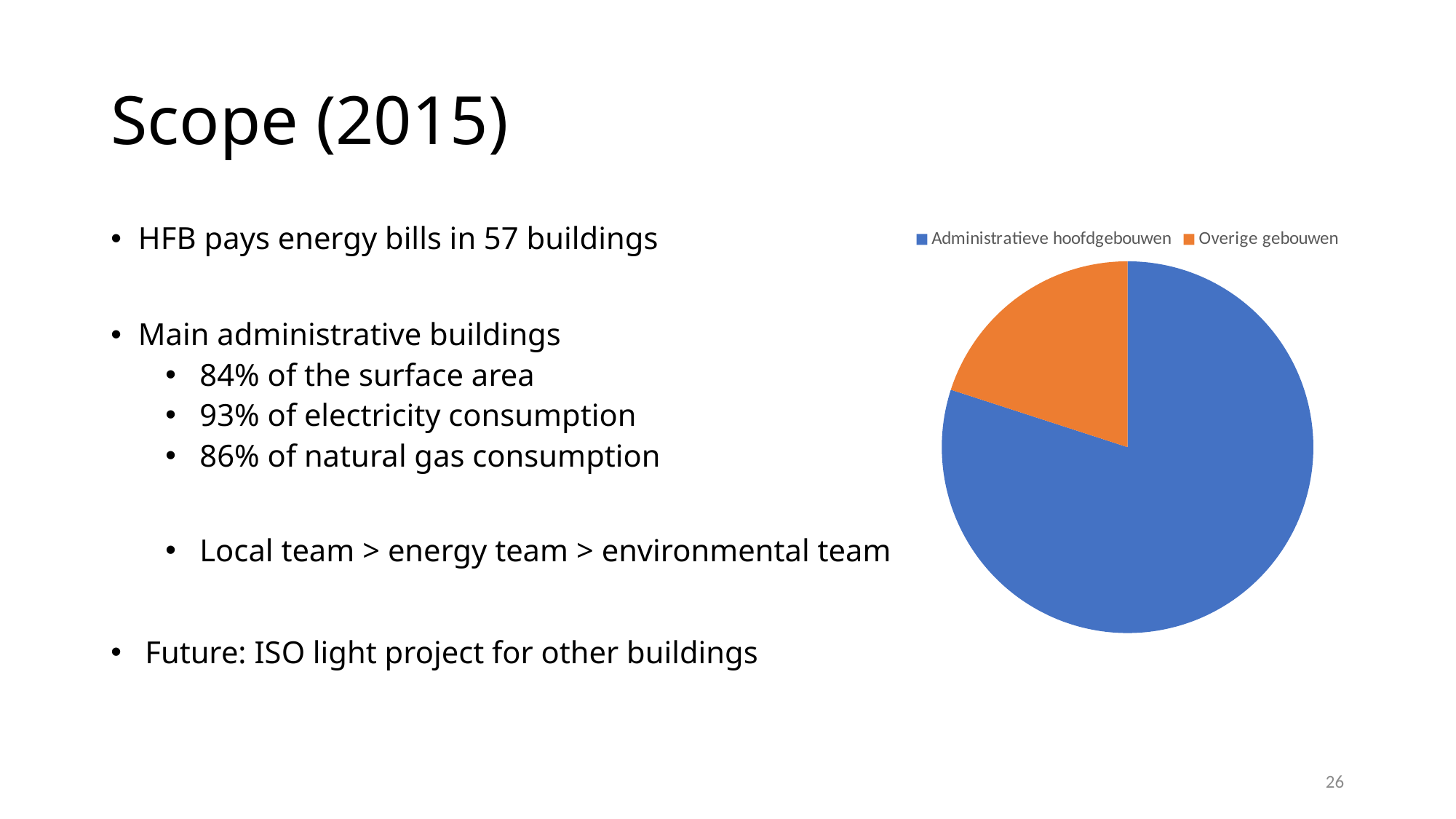
What kind of chart is shown on the slide? pie chart Which slice of the pie chart is the smallest? Overige gebouwen Which legend entry in the pie chart is shown in blue? Administratieve hoofdgebouwen How many slices does the pie chart have? 2 What colour is the Overige gebouwen slice in the pie chart? orange In the pie chart, which is larger: Administratieve hoofdgebouwen or Overige gebouwen? Administratieve hoofdgebouwen How many entries does the legend of the pie chart list? 2 Which slice of the pie chart is the largest? Administratieve hoofdgebouwen